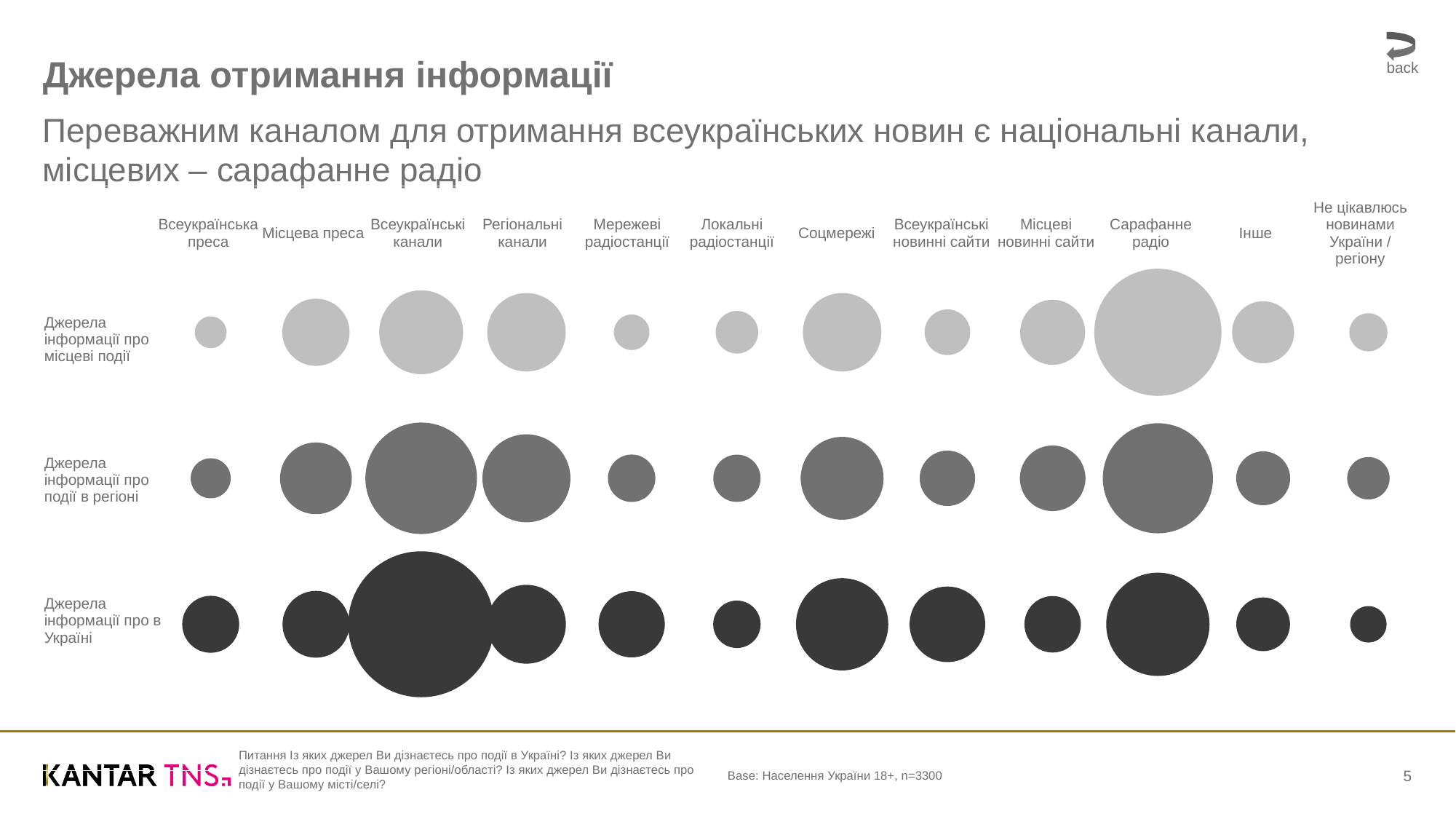
What is the title of the slide? Джерела отримання інформації How many rows (series) of bubbles does the chart show? 3 In the row 'Джерела інформації про в Україні', which source has the largest bubble? Всеукраїнські канали In the row 'Джерела інформації про місцеві події', which bubble is larger: 'Місцева преса' or 'Всеукраїнська преса'? Місцева преса For 'Сарафанне радіо', which row has the larger bubble: 'Джерела інформації про місцеві події' or 'Джерела інформації про в Україні'? Джерела інформації про місцеві події In the row 'Джерела інформації про в Україні', which bubble is larger: 'Всеукраїнські канали' or 'Регіональні канали'? Всеукраїнські канали What is the base (sample size) stated at the bottom of the slide? Населення України 18+, n=3300 How many information-source categories are shown along the top of the chart? 12 In the row 'Джерела інформації про місцеві події', which source has the largest bubble? Сарафанне радіо What kind of chart is shown on the slide? bubble chart